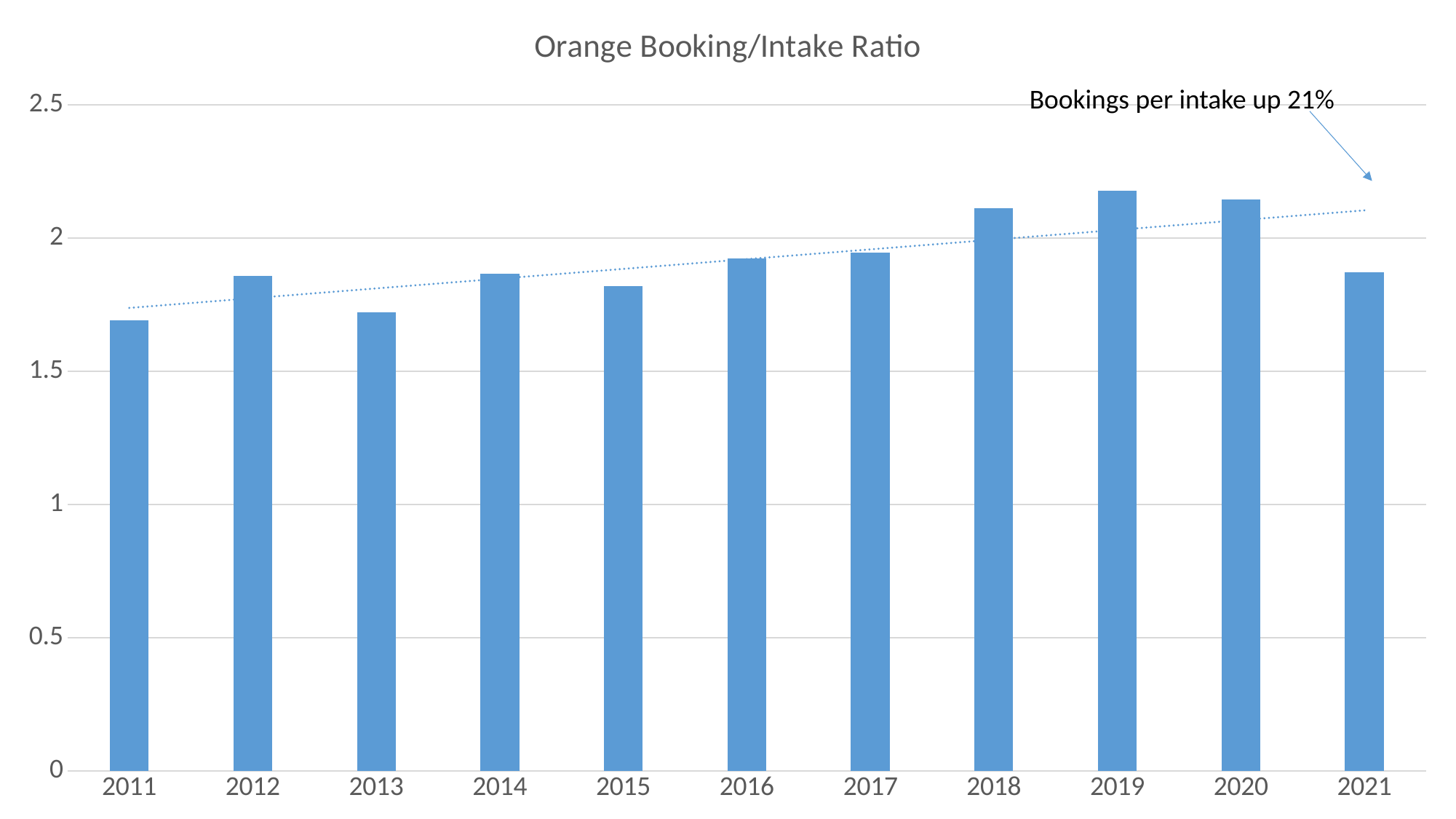
Which is larger, the value for 2012 or the value for 2013? 2012 How many years are plotted on the x axis? 11 What does the annotation text on the chart say? Bookings per intake up 21% Is the value for 2018 greater or less than 2? greater Which year has the highest booking/intake ratio? 2019 Which is larger, the value for 2020 or the value for 2021? 2020 Is the value for 2021 greater or less than 2? less Is the value for 2016 greater or less than 1.5? greater What is the title of the chart? Orange Booking/Intake Ratio According to the dotted trend line, do the values generally rise or fall from 2011 to 2021? Rise What kind of chart is shown on the slide? Bar chart